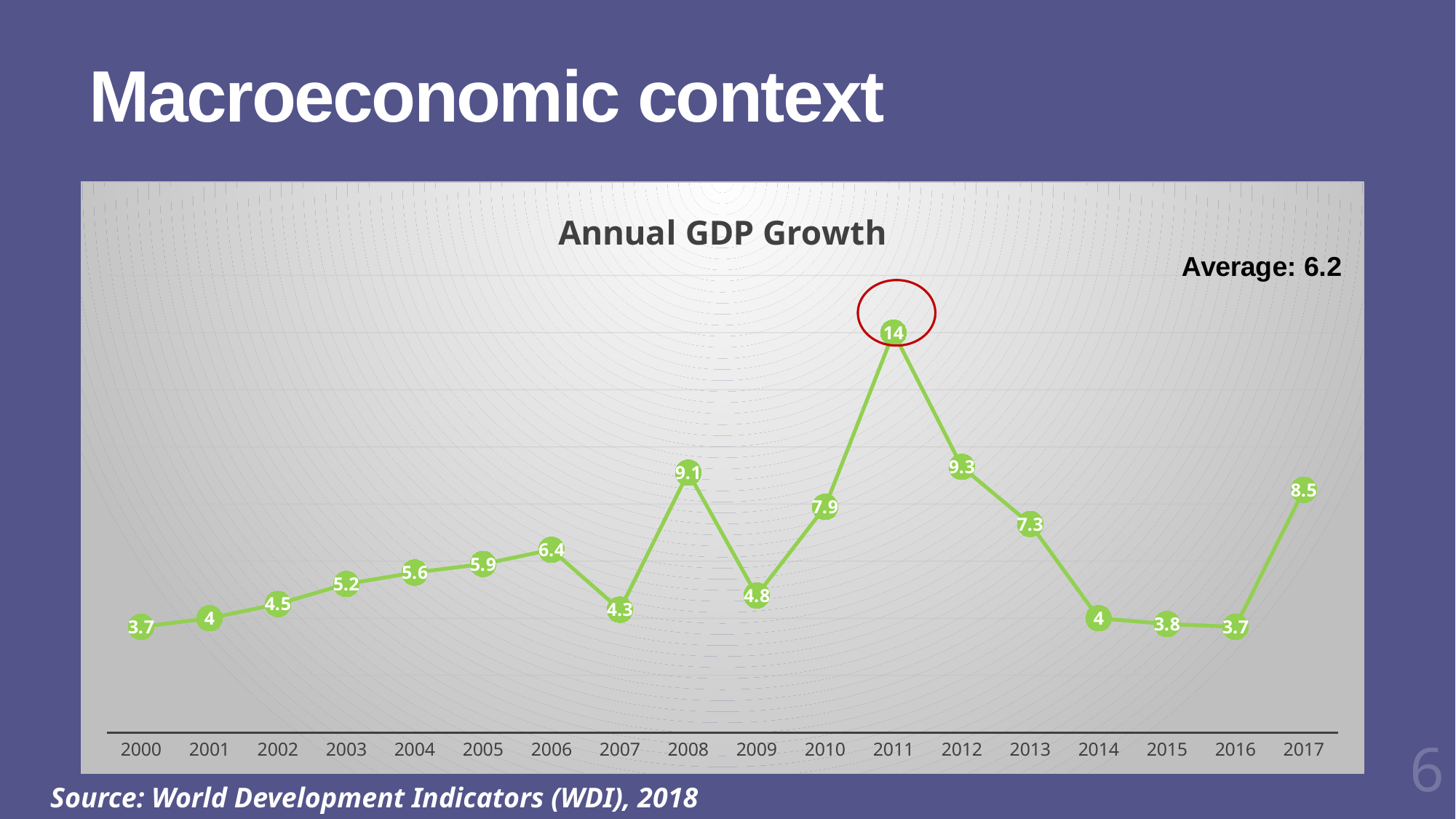
What is the annual GDP growth value for 2008? 9.1 What is the annual GDP growth value for 2011? 14 What is the difference between the GDP growth values for 2011 and 2012? 4.7 What is the difference between the GDP growth values for 2008 and 2009? 4.3 Which year has the larger GDP growth value, 2010 or 2013? 2010 How many years are plotted on the chart? 18 What is the annual GDP growth value for 2017? 8.5 Which year has the highest annual GDP growth? 2011 What kind of chart is shown on the slide? Line chart Do the GDP growth values rise or fall from 2000 to 2006? Rise What is the title of the chart? Annual GDP Growth What is the lowest annual GDP growth value shown on the chart? 3.7